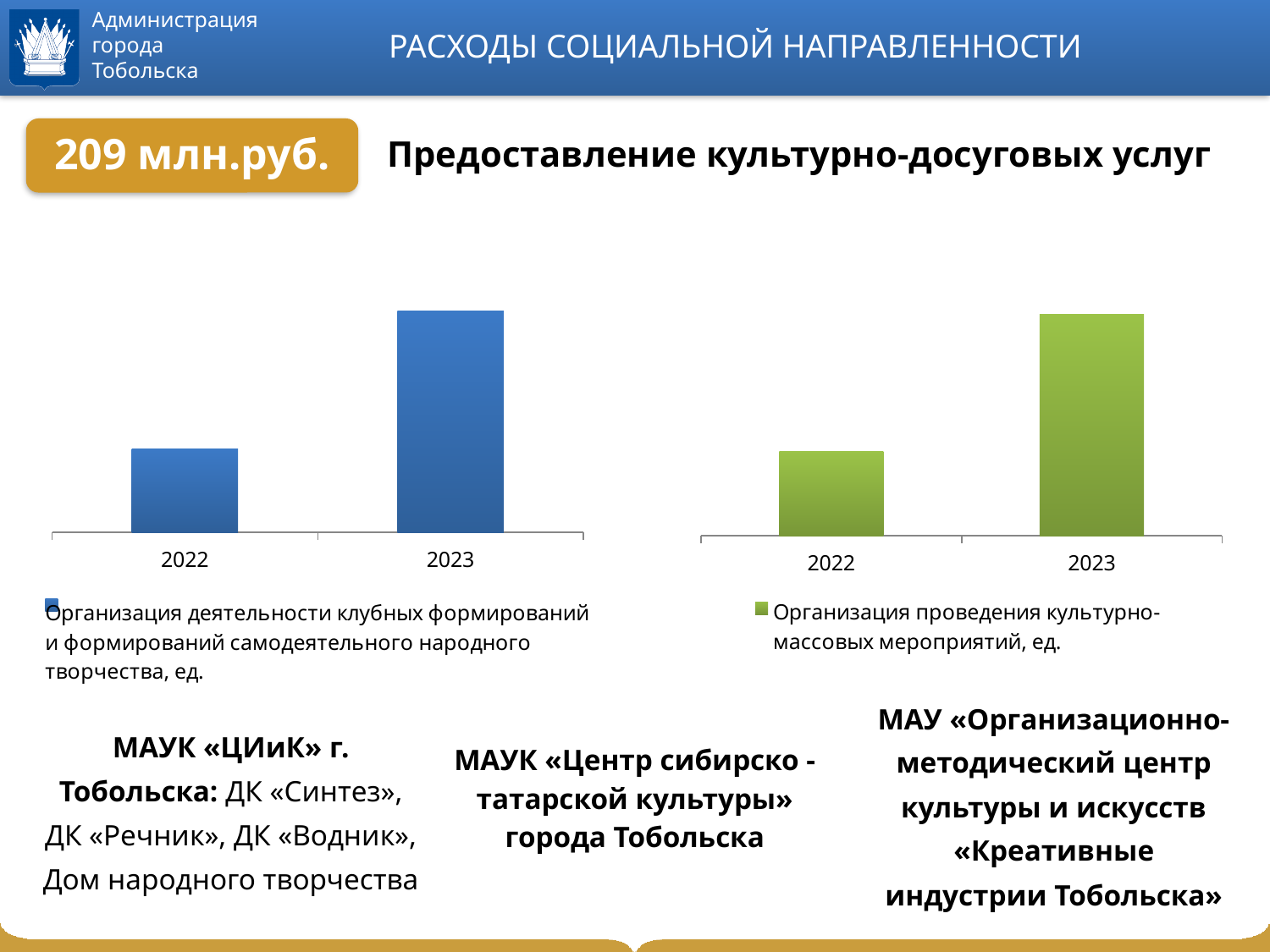
What kind of chart is the right chart (green bars)? bar chart In the right chart (green bars), how many categories are shown on the x axis? 2 In the right chart (green bars), do the values rise or fall from 2022 to 2023? rise In the left chart (blue bars), which year has the higher bar? 2023 What is the legend entry of the right chart (green bars)? Организация проведения культурно-массовых мероприятий, ед. In the left chart (blue bars), how many categories are shown on the x axis? 2 What kind of chart is the left chart (blue bars)? bar chart In the left chart (blue bars), is the value for 2022 larger or smaller than the value for 2023? smaller In the right chart (green bars), which year has the higher bar? 2023 In the left chart (blue bars), which year has the lower bar? 2022 How many series does the legend of the right chart (green bars) list? 1 In the right chart (green bars), which year has the lower bar? 2022